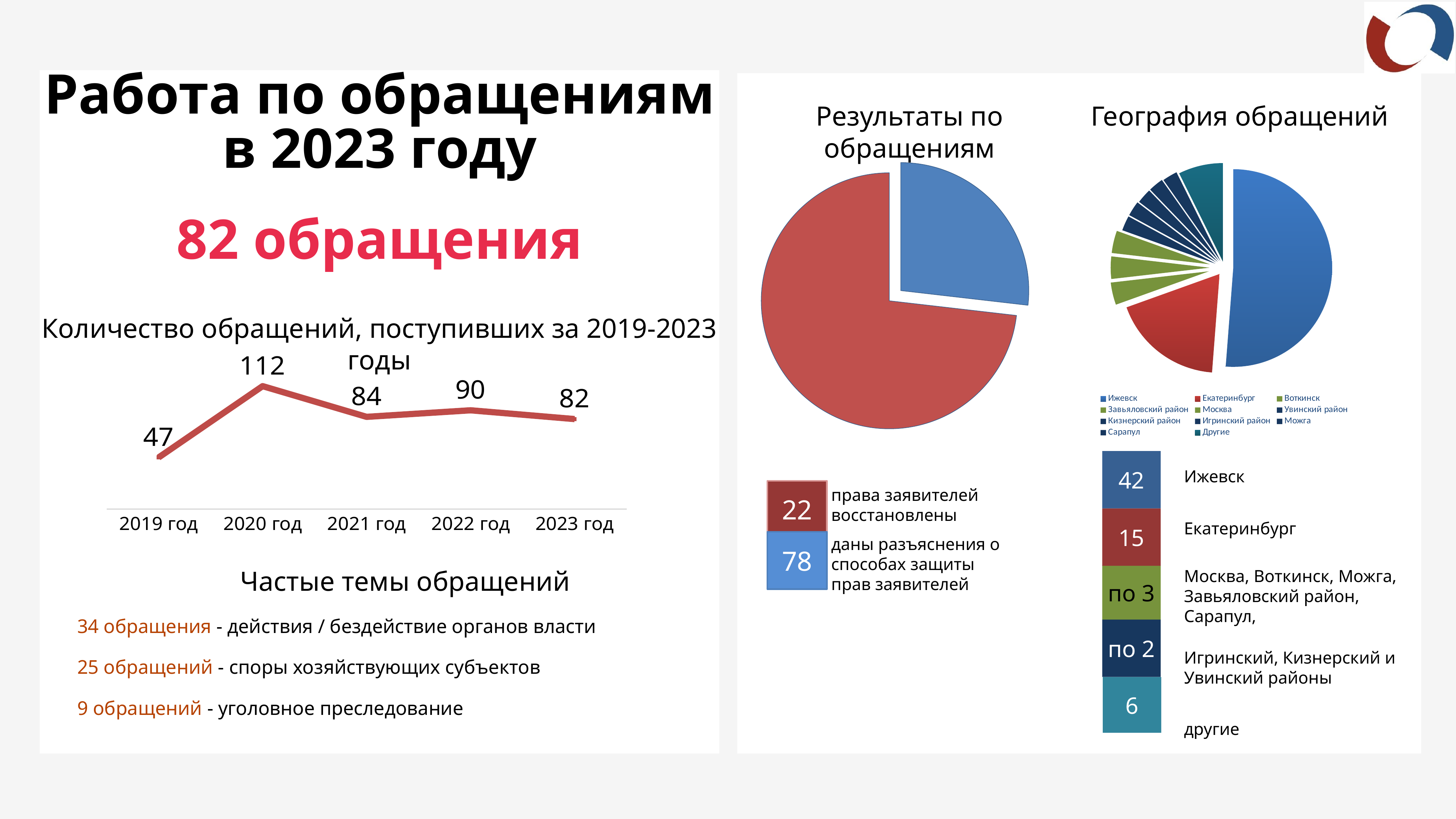
How many data points are plotted in the chart "Количество обращений, поступивших за 2019-2023 годы"? 5 In the chart "Количество обращений, поступивших за 2019-2023 годы", does the value rise or fall from 2022 год to 2023 год? fall In the chart "Количество обращений, поступивших за 2019-2023 годы", what is the value for 2020 год? 112 In the chart "География обращений", which is larger, Ижевск or Екатеринбург? Ижевск In the chart "География обращений", what is the value for Екатеринбург? 15 In the chart "География обращений", what is the value for Ижевск? 42 In the chart "Результаты по обращениям", what is the value for "права заявителей восстановлены"? 22 In the chart "Количество обращений, поступивших за 2019-2023 годы", which year has the highest value? 2020 год In the chart "Количество обращений, поступивших за 2019-2023 годы", which year has the lowest value? 2019 год What kind of chart is "Количество обращений, поступивших за 2019-2023 годы"? line chart How many entries does the legend of the chart "География обращений" list? 11 In the chart "Количество обращений, поступивших за 2019-2023 годы", what is the difference between the values for 2020 год and 2019 год? 65